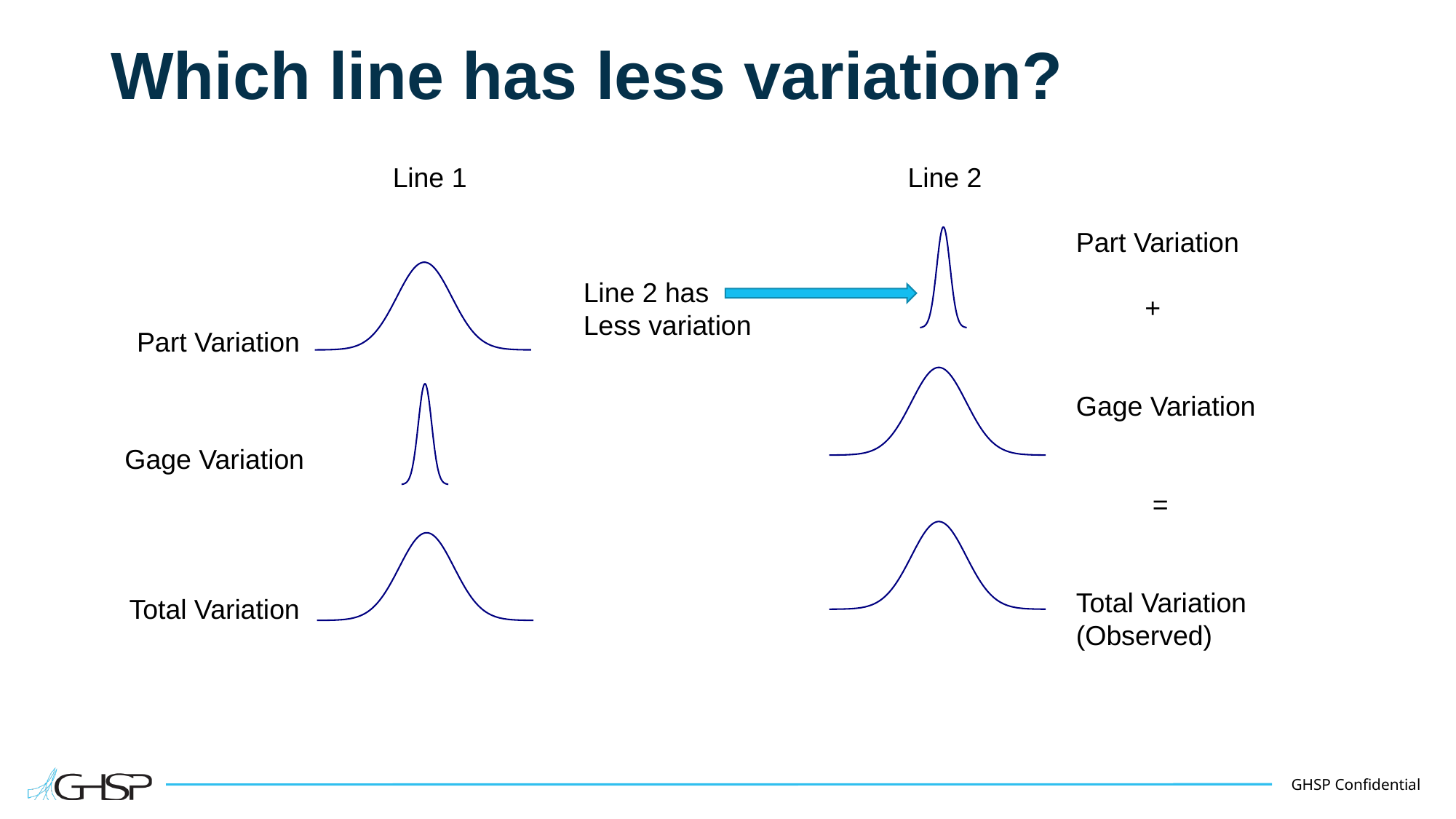
For Line 1, which curve is the narrowest: Part Variation, Gage Variation or Total Variation? Gage Variation How many distribution curves are shown for Line 1? 3 For Line 2, is the Gage Variation curve wider or narrower than the Part Variation curve? wider Which curve is narrower: the Part Variation curve for Line 1 or the Part Variation curve for Line 2? Line 2 How many distribution curves are shown for Line 2? 3 According to the slide, which line has less variation? Line 2 What are the three variation components labelled for each line? Part Variation, Gage Variation, Total Variation